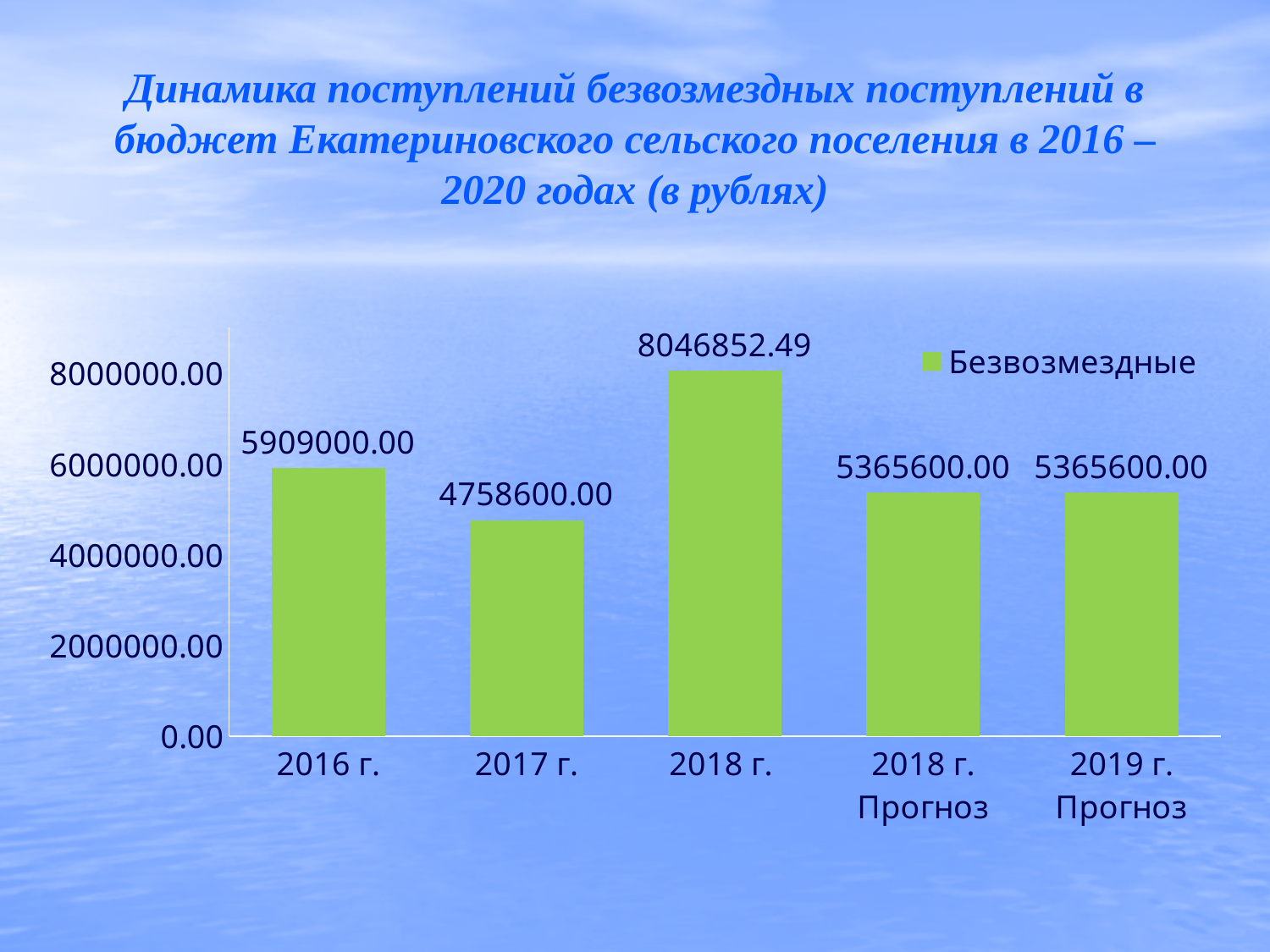
What is the value for 2016 г.? 5909000.00 What is the value for 2018 г.? 8046852.49 What is the difference between the values for 2016 г. and 2018 г. Прогноз? 543400.00 Which category has the lowest value? 2017 г. What series name does the legend show? Безвозмездные What is the difference between the values for 2018 г. and 2017 г.? 3288252.49 Which is larger, the value for 2016 г. or the value for 2017 г.? 2016 г. What is the value for 2019 г. Прогноз? 5365600.00 How many categories are shown on the x axis? 5 What kind of chart is shown on the slide? Bar chart Which category has the highest value? 2018 г. What is the value for 2017 г.? 4758600.00